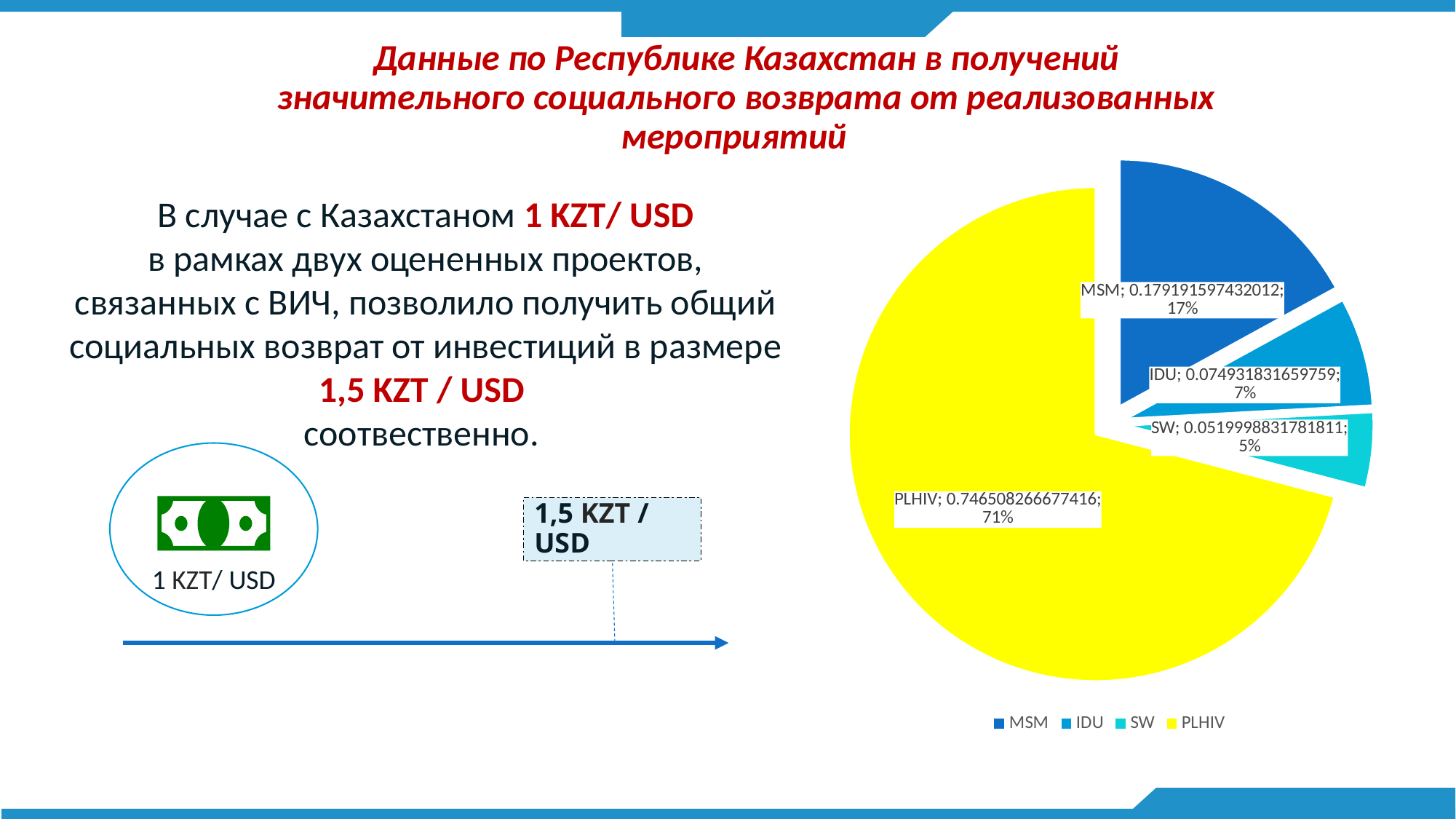
What percentage share does the SW slice have in the pie chart? 5% Which category has the largest slice in the pie chart? PLHIV Which slice is larger in the pie chart, MSM or IDU? MSM What percentage share does the PLHIV slice have in the pie chart? 71% What kind of chart is shown on the slide? pie chart How many entries does the legend of the pie chart list? 4 What colour is the PLHIV slice in the pie chart? yellow What is the difference in percentage points between the PLHIV and MSM shares in the pie chart? 54 What percentage share does the MSM slice have in the pie chart? 17% Which category has the smallest slice in the pie chart? SW How many slices does the pie chart have? 4